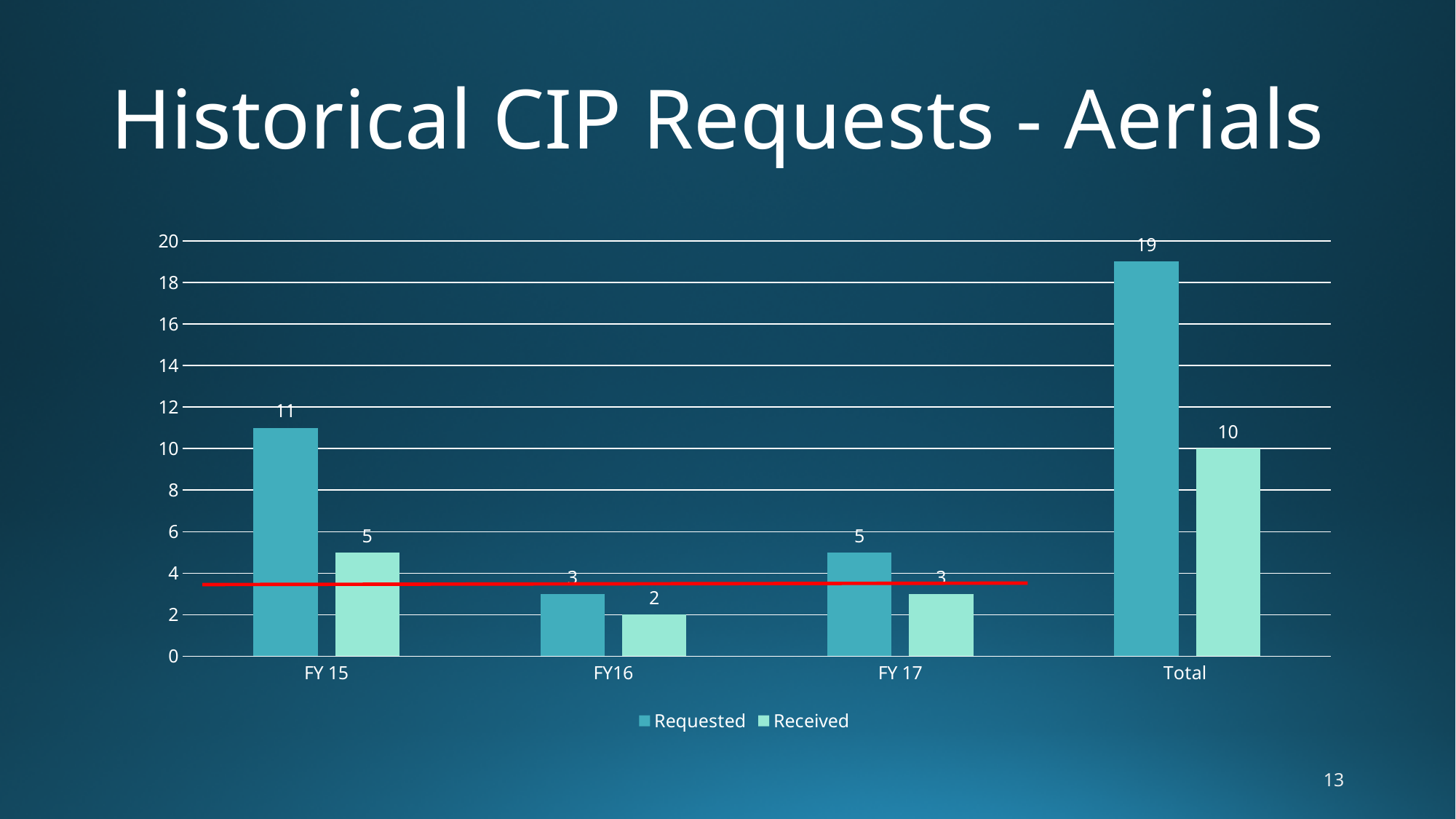
Excluding the Total category, which fiscal year has the highest Requested value? FY 15 What is the title of the slide? Historical CIP Requests - Aerials What is the Received value for FY16? 2 What is the Requested value for Total? 19 What is the Received value for FY 17? 3 What kind of chart is shown on the slide? Bar chart Which is larger for FY 17, the Requested value or the Received value? Requested What is the difference between the Requested and Received values for FY 15? 6 How many series does the legend list? 2 How many categories are shown on the x axis? 4 What is the Requested value for FY 15? 11 Excluding the Total category, which fiscal year has the lowest Received value? FY16